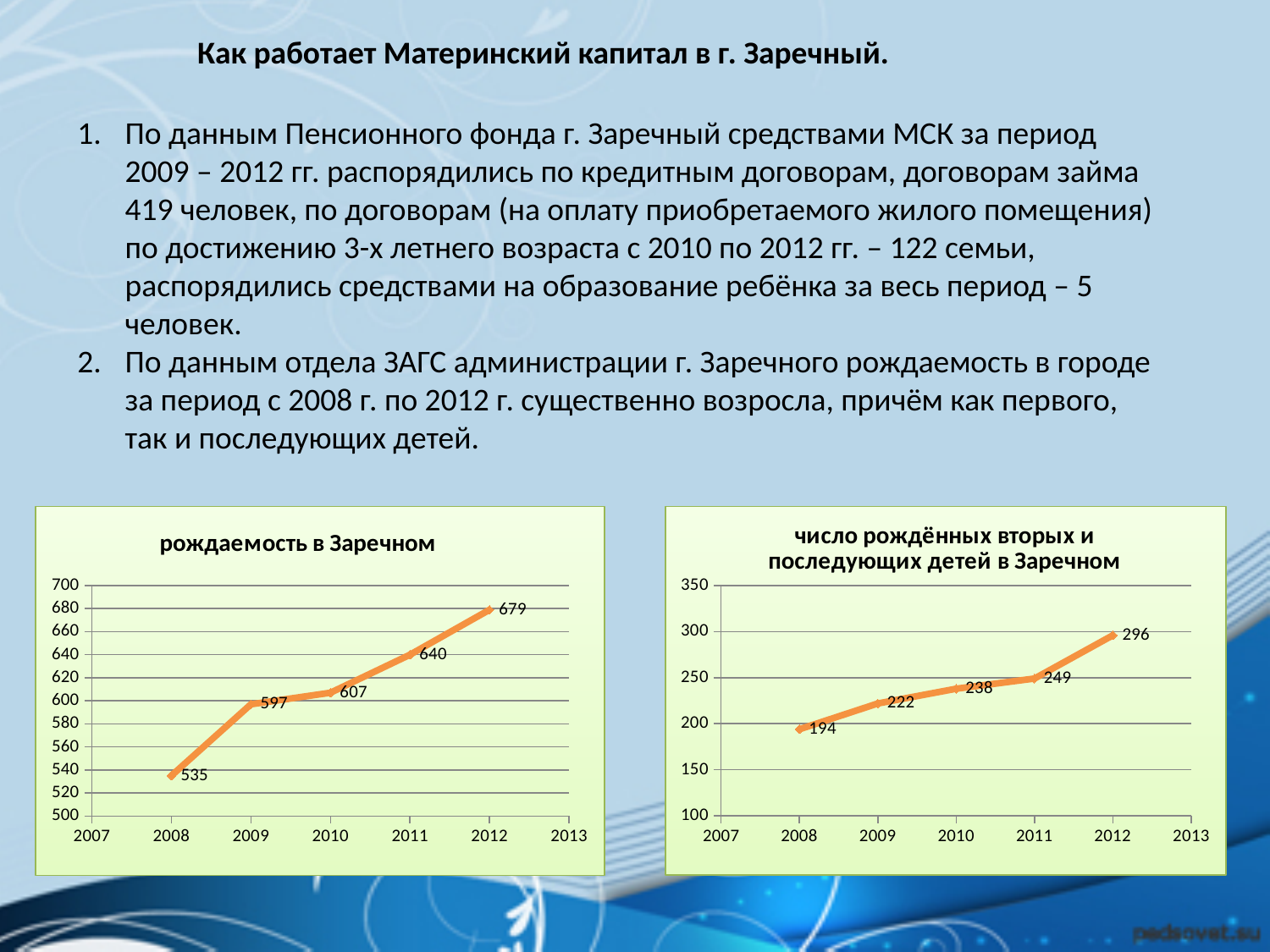
In the chart 'число рождённых вторых и последующих детей в Заречном', which year has the highest value? 2012 In the chart 'рождаемость в Заречном', do the values rise or fall from 2008 to 2012? rise In the chart 'число рождённых вторых и последующих детей в Заречном', is the value for 2011 greater or less than 2010? greater In the chart 'рождаемость в Заречном', how many data points are plotted? 5 In the chart 'число рождённых вторых и последующих детей в Заречном', what is the difference between the values for 2009 and 2008? 28 What type of chart is 'число рождённых вторых и последующих детей в Заречном'? line chart In the chart 'рождаемость в Заречном', what is the value for 2012? 679 In the chart 'рождаемость в Заречном', which year has the lowest value? 2008 In the chart 'число рождённых вторых и последующих детей в Заречном', what is the value for 2010? 238 In the chart 'рождаемость в Заречном', what is the difference between the values for 2012 and 2008? 144 In the chart 'число рождённых вторых и последующих детей в Заречном', is the value for 2008 greater or less than 200? less In the chart 'рождаемость в Заречном', what is the value for 2008? 535